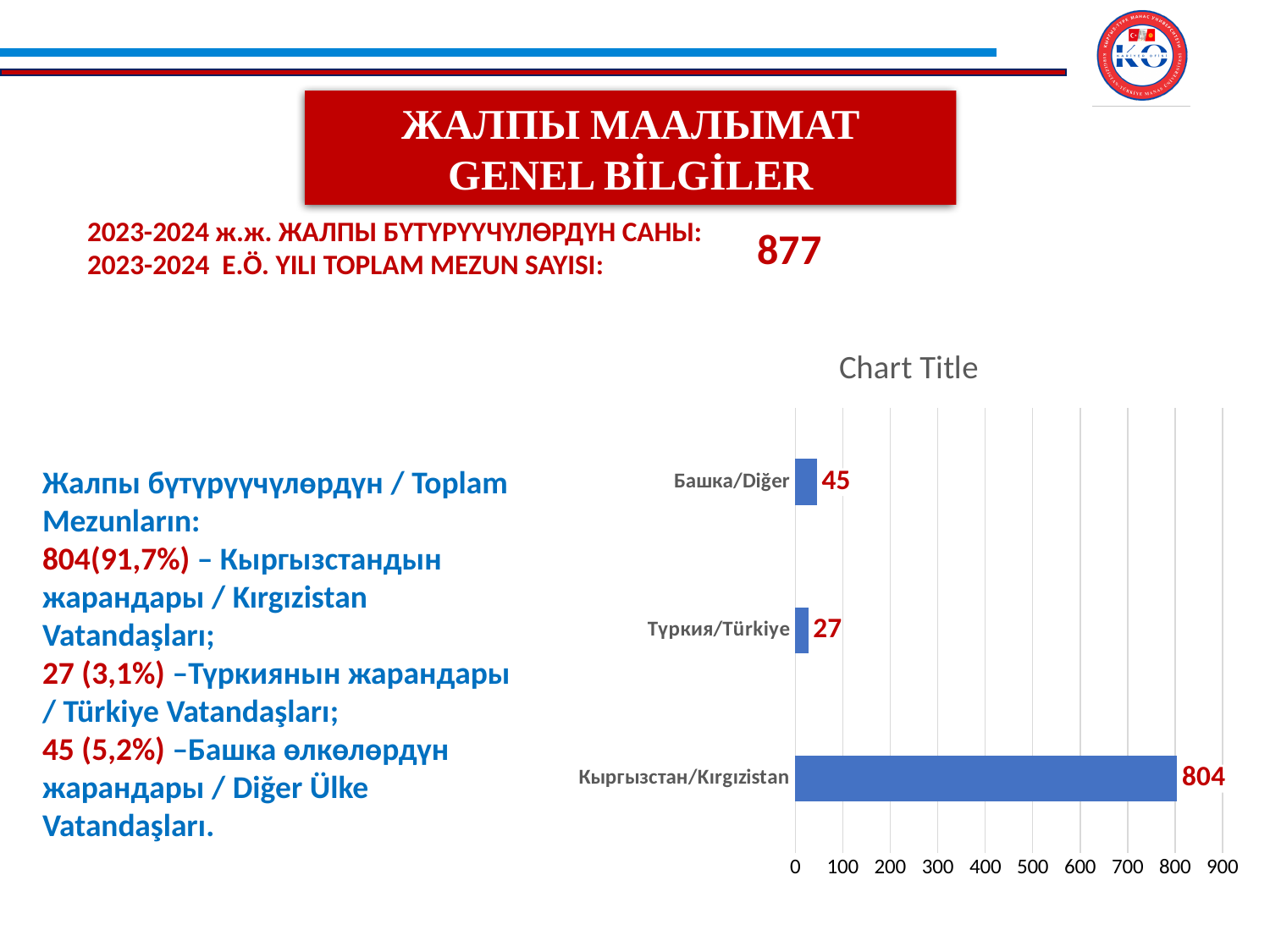
What is the title of the chart? Chart Title What is the value for Кыргызстан/Kırgızistan? 804 Is the value for Кыргызстан/Kırgızistan greater or less than 700? greater What is the value for Түркия/Türkiye? 27 Which category has the highest value? Кыргызстан/Kırgızistan How many categories are shown in the chart? 3 What is the difference between the values for Башка/Diğer and Түркия/Türkiye? 18 Which category has the lowest value? Түркия/Türkiye What is the value for Башка/Diğer? 45 What kind of chart is shown on the slide? bar chart What is the difference between the values for Кыргызстан/Kırgızistan and Башка/Diğer? 759 Which is larger, the value for Башка/Diğer or the value for Түркия/Türkiye? Башка/Diğer